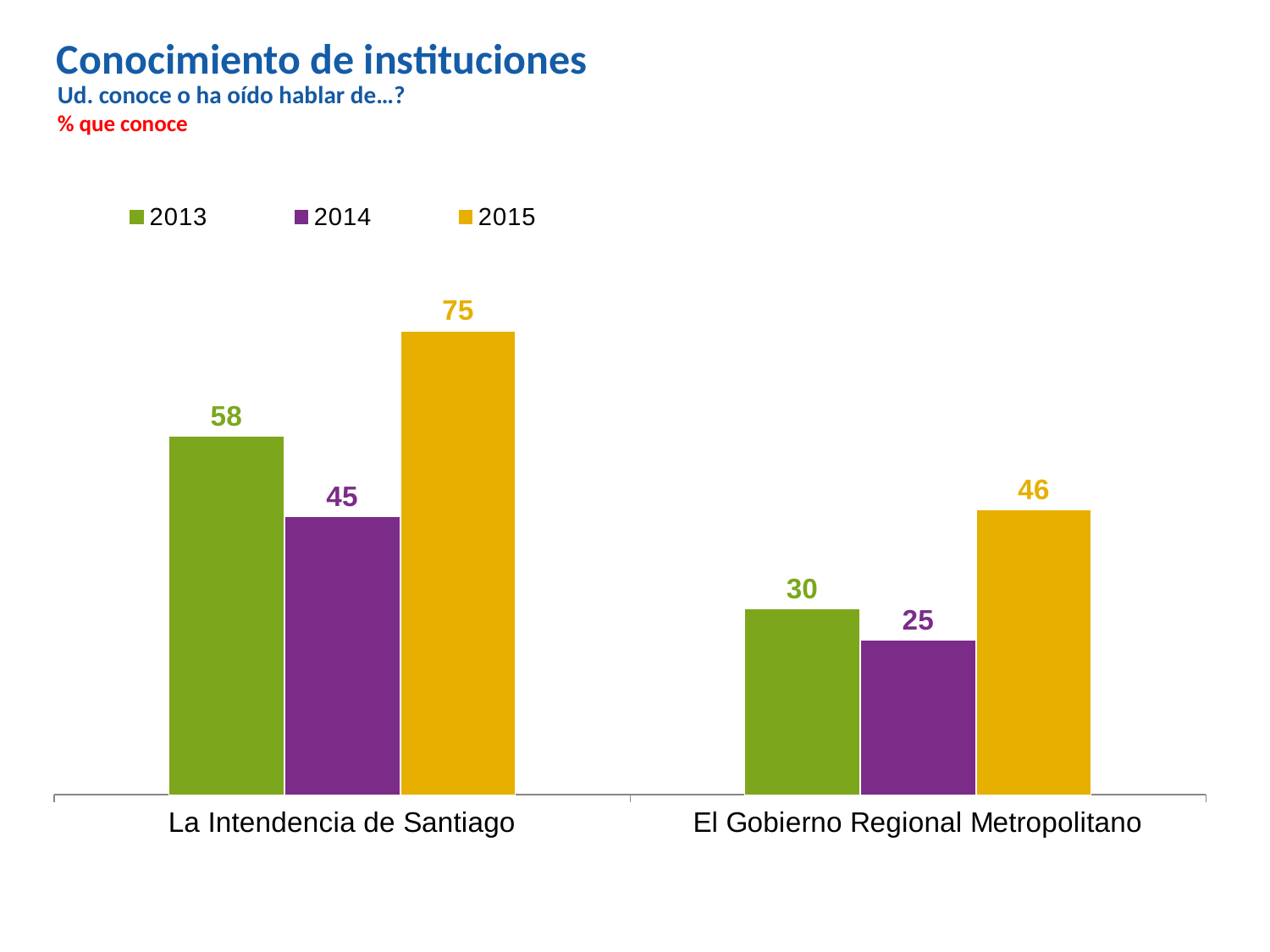
How many series does the legend list? 3 What is the 2013 value for La Intendencia de Santiago? 58 How many categories are shown on the x axis? 2 What is the difference between the 2015 and 2013 values for La Intendencia de Santiago? 17 What kind of chart is shown on the slide? Bar chart What is the 2014 value for El Gobierno Regional Metropolitano? 25 Which colour represents the 2014 series in the legend? Purple What is the 2015 value for La Intendencia de Santiago? 75 Which year has the lowest value for La Intendencia de Santiago? 2014 Which year has the highest value for El Gobierno Regional Metropolitano? 2015 What is the difference between the 2013 values for La Intendencia de Santiago and El Gobierno Regional Metropolitano? 28 Which is larger: the 2014 value for La Intendencia de Santiago or the 2015 value for El Gobierno Regional Metropolitano? 2015 value for El Gobierno Regional Metropolitano